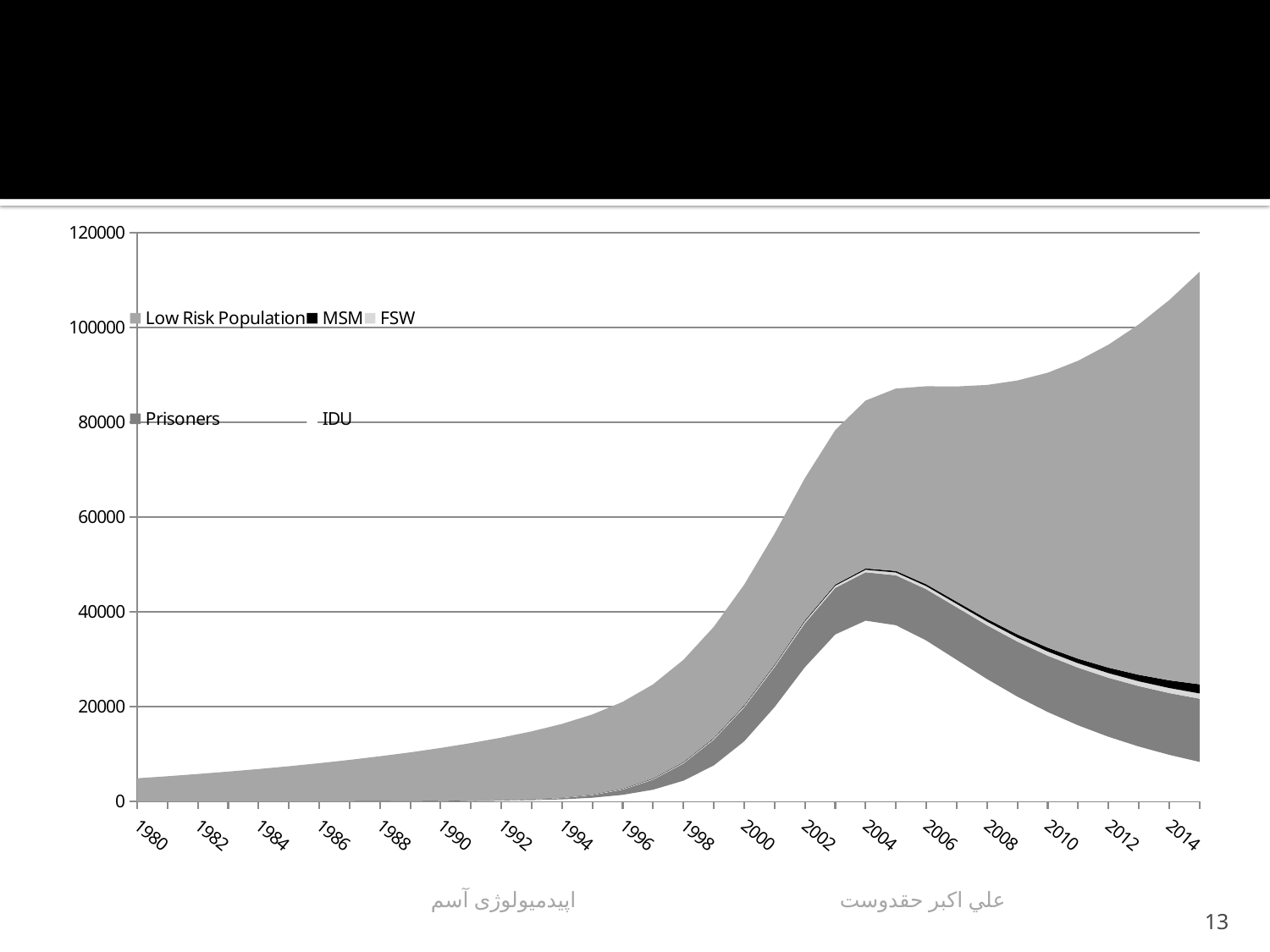
Does the total stacked value rise or fall from 1980 to 2014? rise Which series are listed in the chart legend? Low Risk Population, MSM, FSW, Prisoners, IDU How many year labels are shown along the x axis? 18 What is the highest value shown on the vertical axis? 120000 Is the total stacked value in 2010 greater or less than 100000? less Is the total stacked value in 1980 greater or less than 20000? less Is the total stacked value in 2004 greater or less than 80000? greater How many series does the legend list? 5 What kind of chart is shown on the slide? Area chart Is the total stacked value larger in 2014 or in 1990? 2014